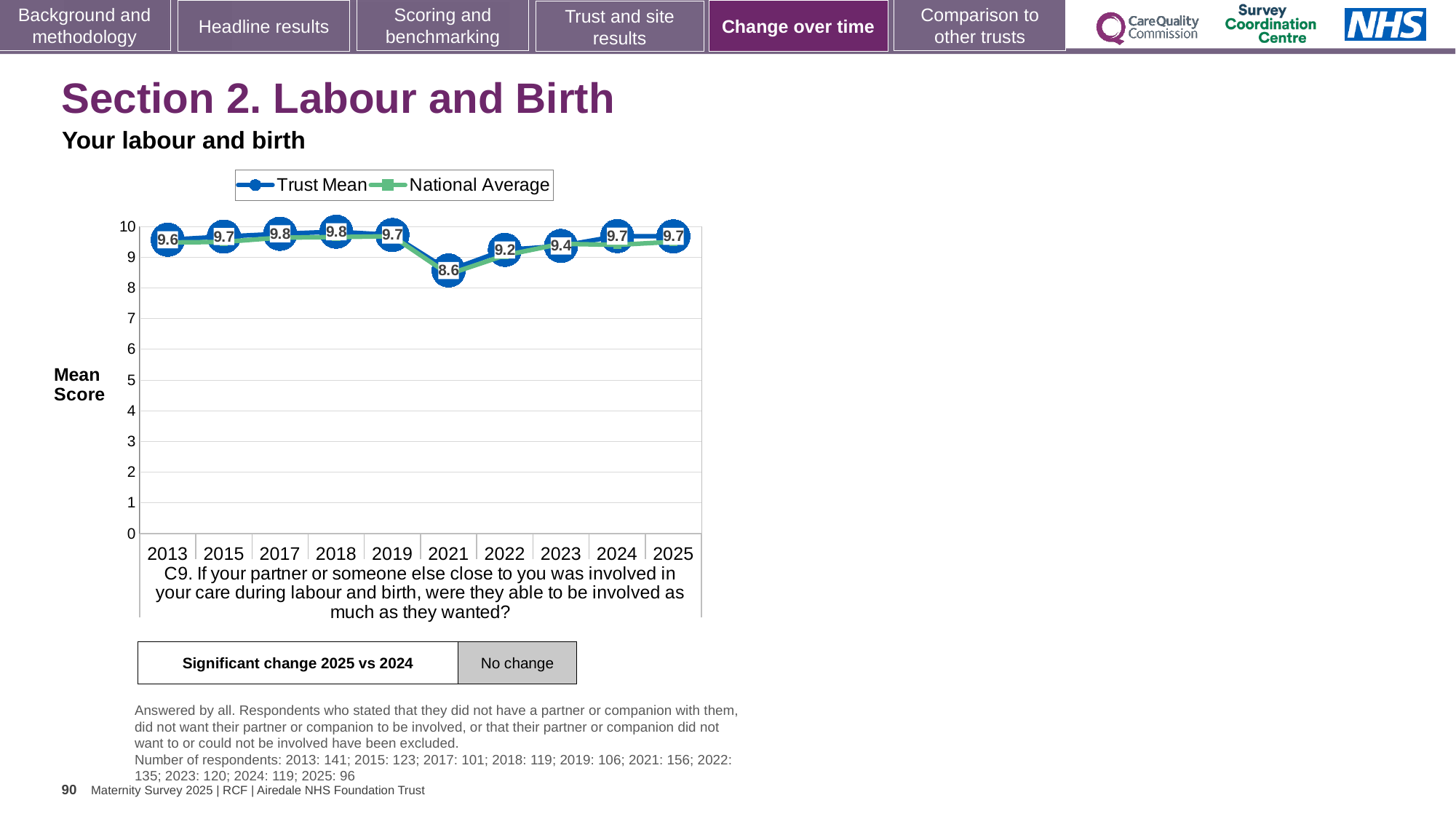
What is the Trust Mean value for 2021? 8.6 What is the difference between the Trust Mean in 2022 and in 2021? 0.6 What kind of chart is shown? line chart In which year is the Trust Mean lowest? 2021 How many years are shown on the x axis? 10 Does the Trust Mean rise or fall from 2021 to 2024? rise How many series does the legend list? 2 Which year has the larger Trust Mean, 2022 or 2023? 2023 What is the Trust Mean value for 2013? 9.6 What is the label of the y axis? Mean Score Is the National Average value for 2021 greater or less than 9? less What is the Trust Mean value for 2025? 9.7